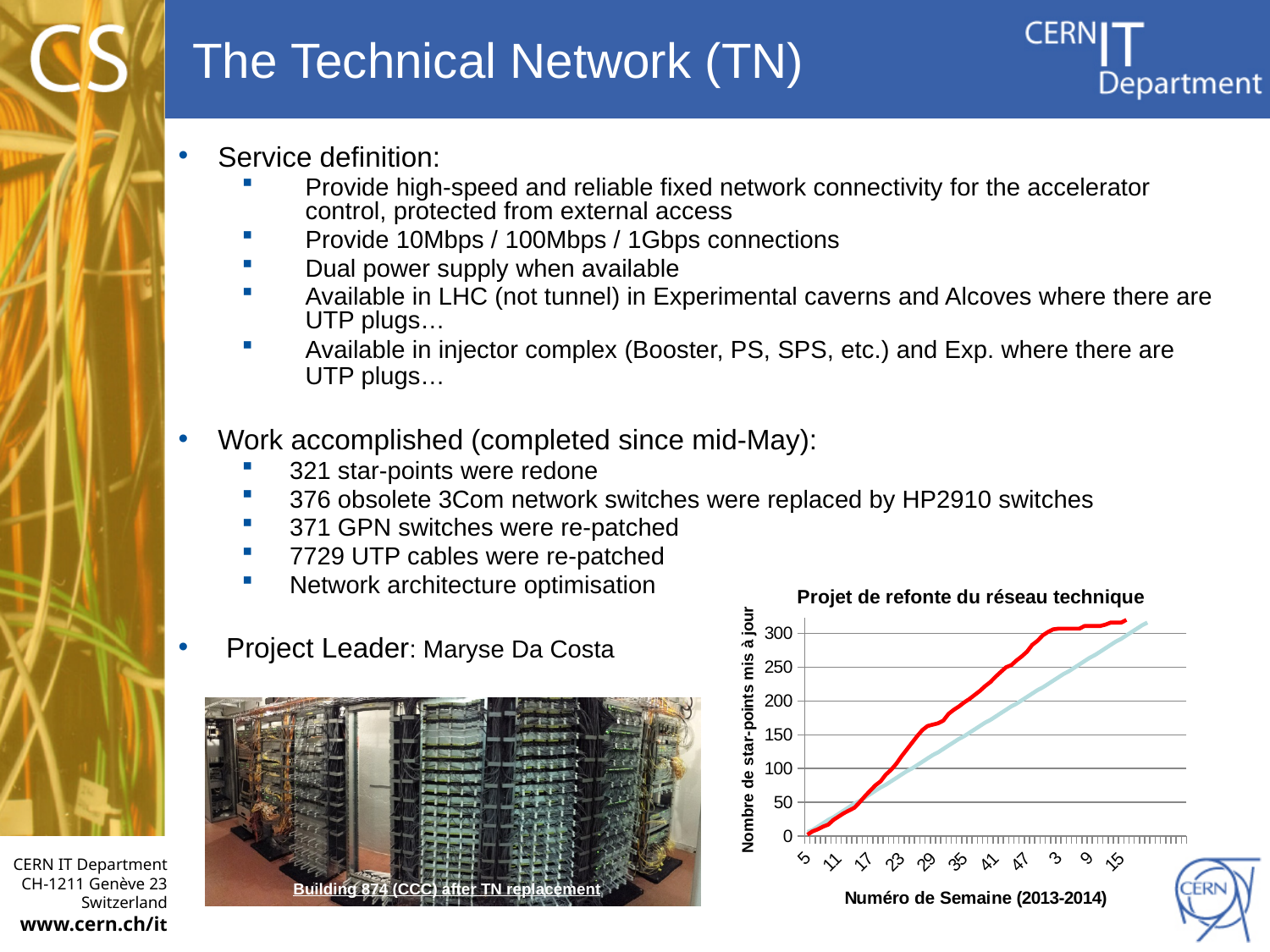
What is the label of the x axis of the chart? Numéro de Semaine (2013-2014) What is the highest value shown on the y axis of the chart? 300 Is the value of the light blue line at week 41 greater or less than 250? less Do the values of the red line rise or fall as the week number advances along the x axis? rise Is the value of the red line at week 29 greater or less than 150? greater What kind of chart is shown on the slide? line chart Is the value of the red line at week 3 greater or less than 250? greater What is the title of the chart? Projet de refonte du réseau technique At week 35, which line has the higher value, the red line or the light blue line? the red line How many lines are plotted on the chart? 2